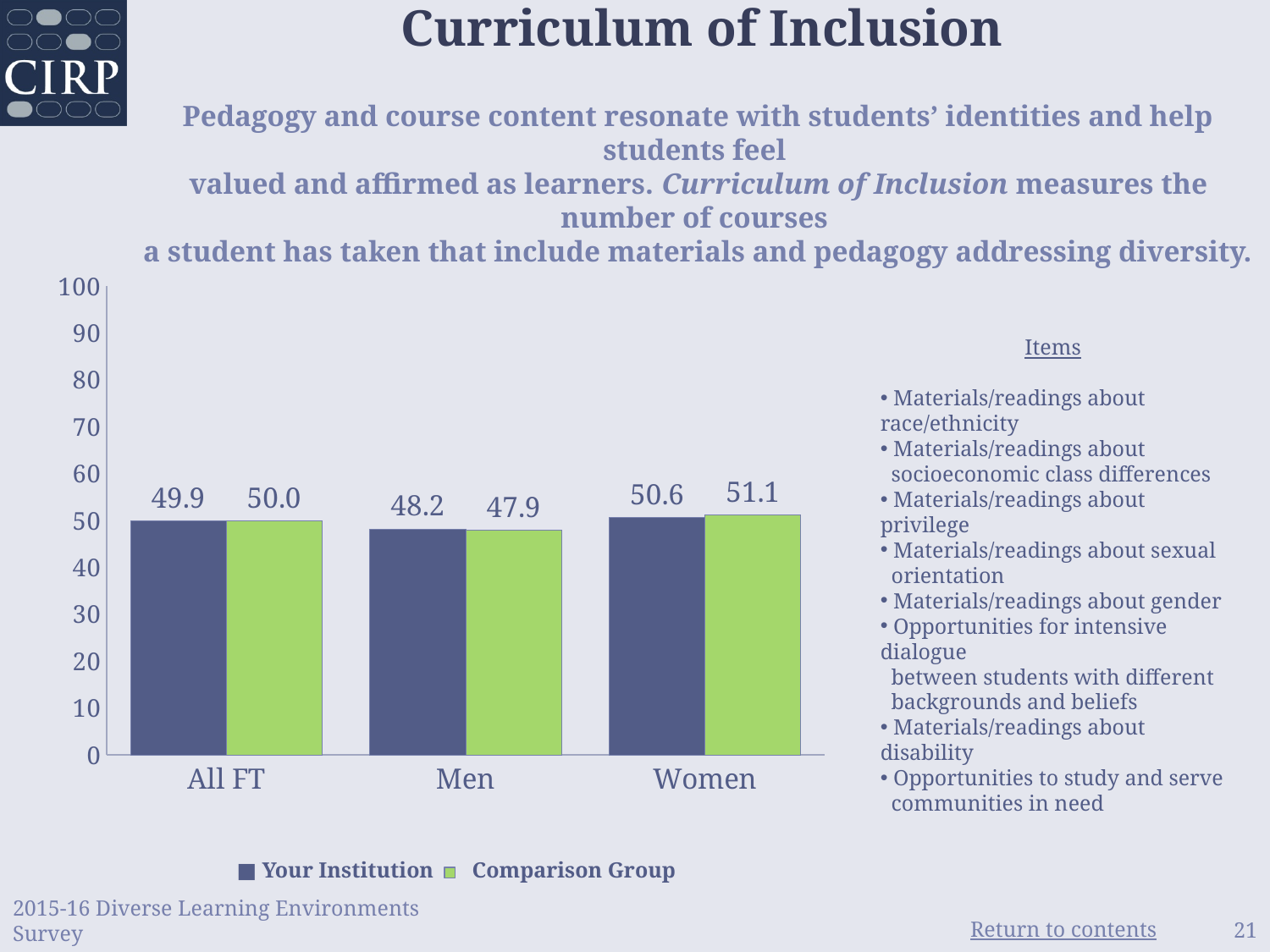
Is the value for Your Institution in the Men category greater or less than 60? less How many series does the legend list? 2 Which category has the lowest value for the Comparison Group? Men How many categories are shown on the x axis? 3 What kind of chart is shown on the slide? bar chart What is the value for the Comparison Group in the Men category? 47.9 What is the difference between Your Institution's values for Women and Men? 2.4 What is the value for Your Institution in the Men category? 48.2 What is the value for the Comparison Group in the Women category? 51.1 What is the value for Your Institution in the All FT category? 49.9 Which category has the highest value for Your Institution? Women What is the difference between the Comparison Group and Your Institution values for Women? 0.5